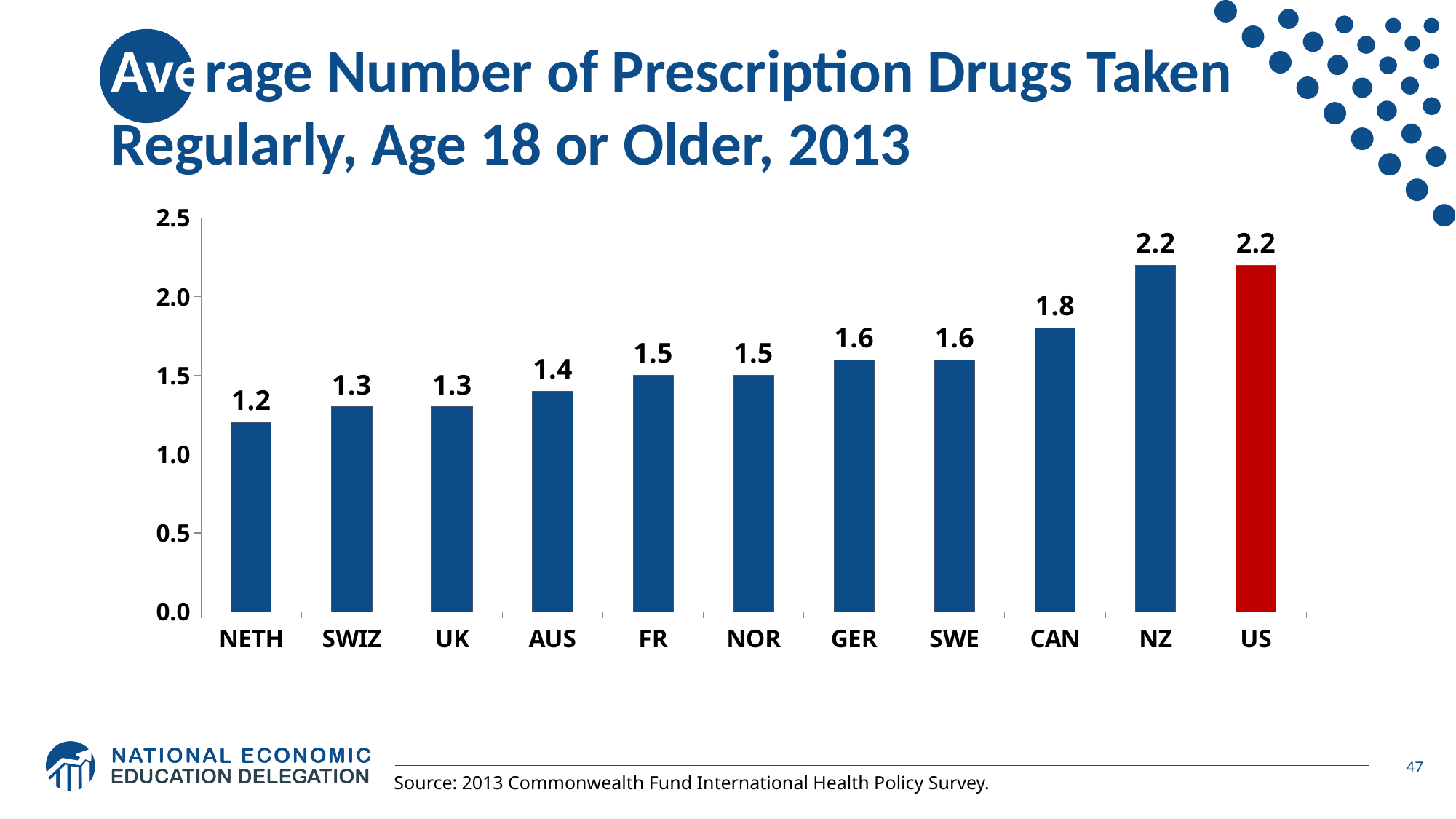
What is the value shown for GER? 1.6 Do the values generally rise or fall from left to right across the chart? Rise What is the average number of prescription drugs taken regularly for CAN? 1.8 Which is larger, the value for SWE or the value for FR? SWE What is the value shown for NETH? 1.2 How many countries are shown on the chart? 11 Which country's bar is coloured red? US Is the value for NZ greater or less than 2.0? greater What is the difference between the values for CAN and AUS? 0.4 What is the difference between the values for US and NETH? 1.0 Which country has the lowest value on the chart? NETH What kind of chart is shown on the slide? Bar chart